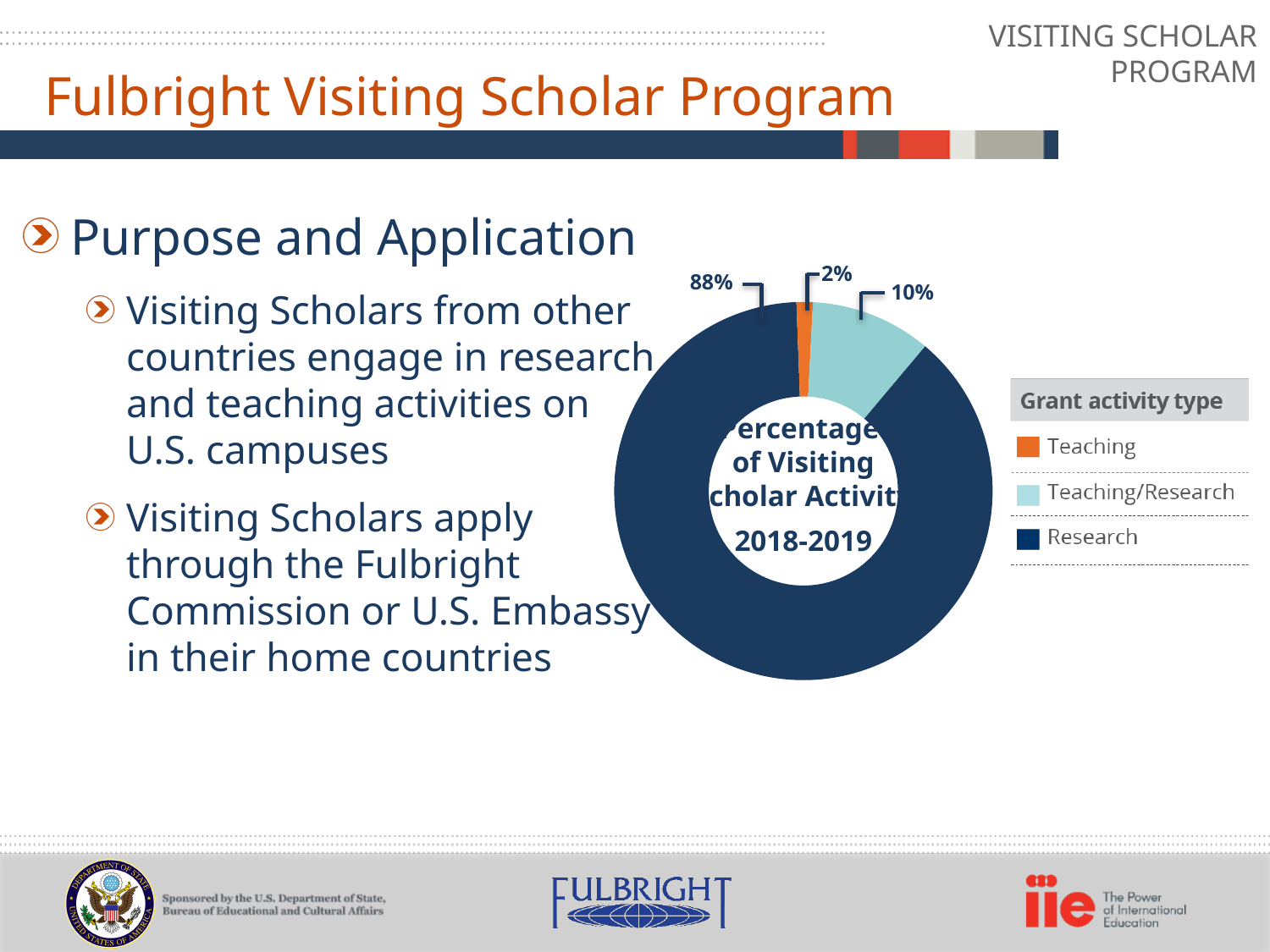
What is the difference in percentage points between Teaching/Research and Teaching? 8 What is the title of the chart's legend? Grant activity type What is the difference in percentage points between Research and Teaching/Research? 78 Which is larger, the share for Teaching/Research or the share for Teaching? Teaching/Research What percentage of visiting scholar activity is Teaching? 2% Which grant activity type has the smallest share of the chart? Teaching What kind of chart is shown on the slide? Pie chart (donut) What percentage of visiting scholar activity is Research? 88% What percentage of visiting scholar activity is Teaching/Research? 10% Which grant activity type has the largest share of the chart? Research How many grant activity types are shown in the chart? 3 What colour represents Teaching in the chart? Orange